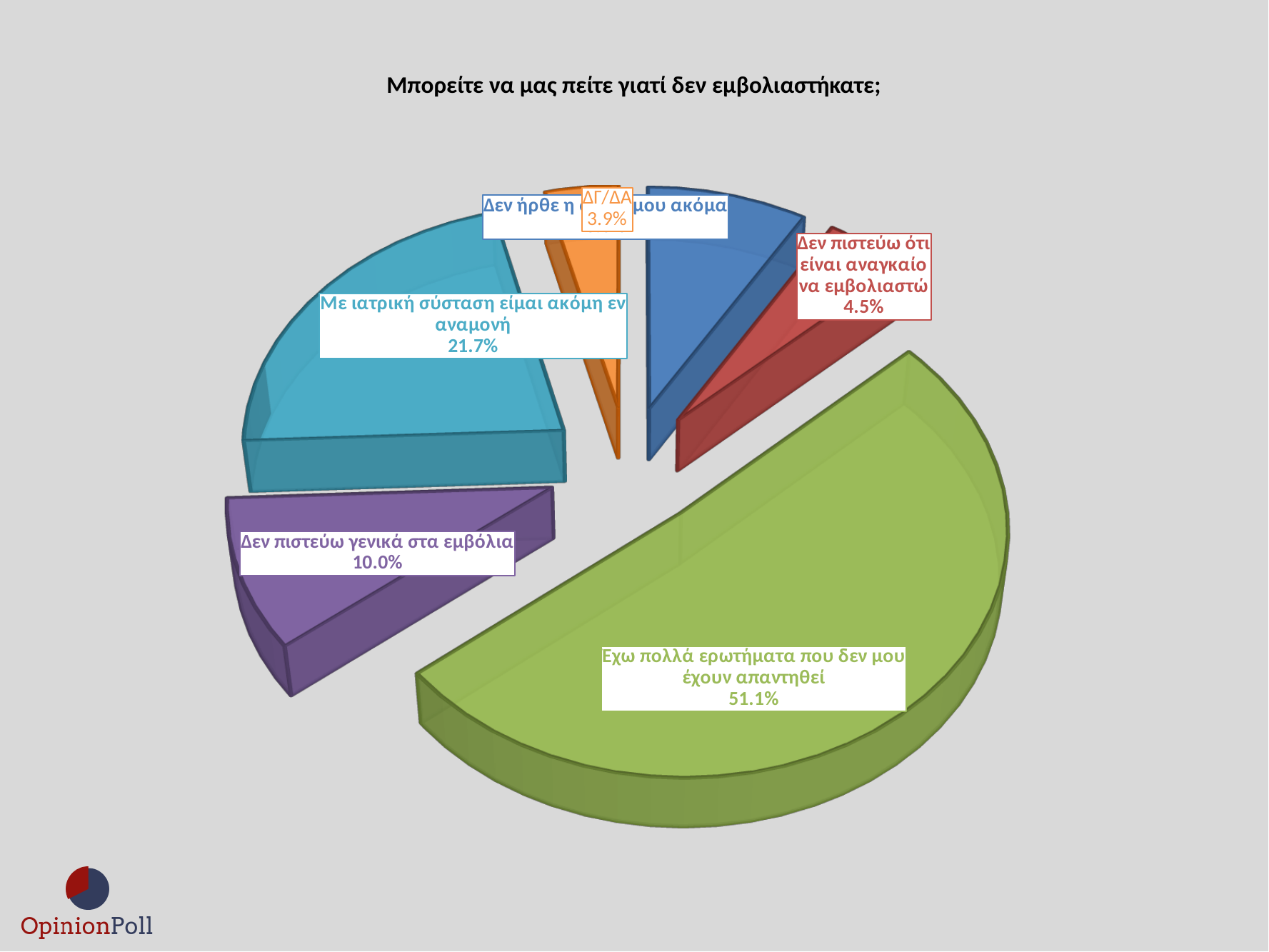
Which is larger: "Δεν πιστεύω γενικά στα εμβόλια" or "Δεν πιστεύω ότι είναι αναγκαίο να εμβολιαστώ"? Δεν πιστεύω γενικά στα εμβόλια How many slices does the pie chart have? 6 What percentage is shown for "Δεν πιστεύω γενικά στα εμβόλια"? 10.0% What is the value for "Δεν πιστεύω ότι είναι αναγκαίο να εμβολιαστώ"? 4.5% Which answer has the largest slice of the pie? Έχω πολλά ερωτήματα που δεν μου έχουν απαντηθεί What type of chart is shown on the slide? Pie chart What is the value shown for "Με ιατρική σύσταση είμαι ακόμη εν αναμονή"? 21.7% Which answer has the smallest slice of the pie? ΔΓ/ΔΑ What percentage of respondents answered "Έχω πολλά ερωτήματα που δεν μου έχουν απαντηθεί"? 51.1% How many percentage points larger is "Έχω πολλά ερωτήματα που δεν μου έχουν απαντηθεί" than "Με ιατρική σύσταση είμαι ακόμη εν αναμονή"? 29.4 percentage points What is the title of the chart? Μπορείτε να μας πείτε γιατί δεν εμβολιαστήκατε; What percentage is labelled ΔΓ/ΔΑ? 3.9%